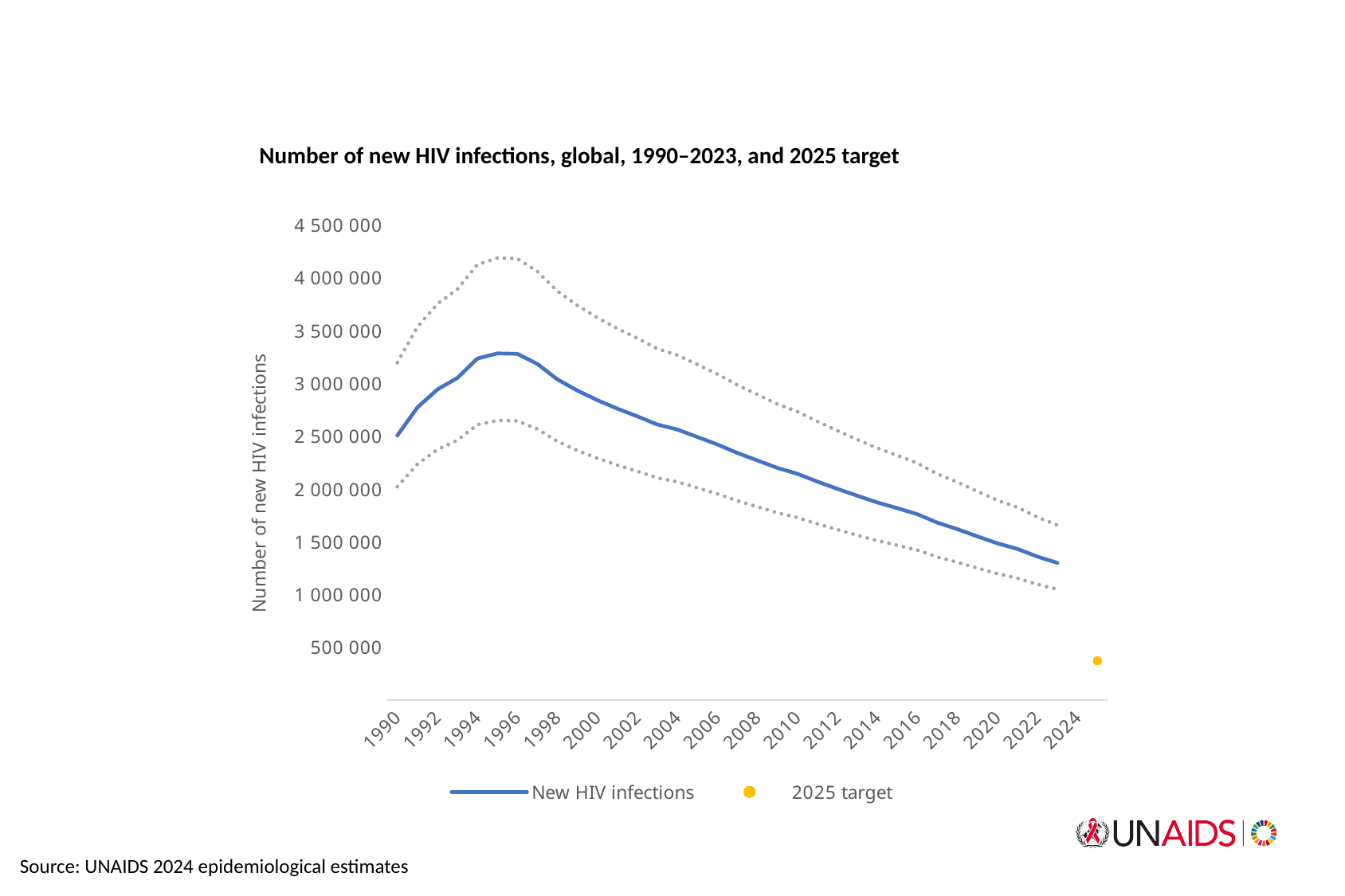
Is the value for New HIV infections in 2010 greater or less than 2 000 000? greater Which year has the larger number of new HIV infections, 1996 or 2010? 1996 Is the 2025 target greater or less than 500 000? less Between 2000 and 2023, do new HIV infections rise or fall? fall What is the label on the vertical axis? Number of new HIV infections Which year has the larger number of new HIV infections, 1990 or 2023? 1990 What is the title of the chart? Number of new HIV infections, global, 1990–2023, and 2025 target Is the value for New HIV infections in 2023 greater or less than 1 500 000? less How many series does the legend list? 2 What kind of chart is shown on the slide? line chart